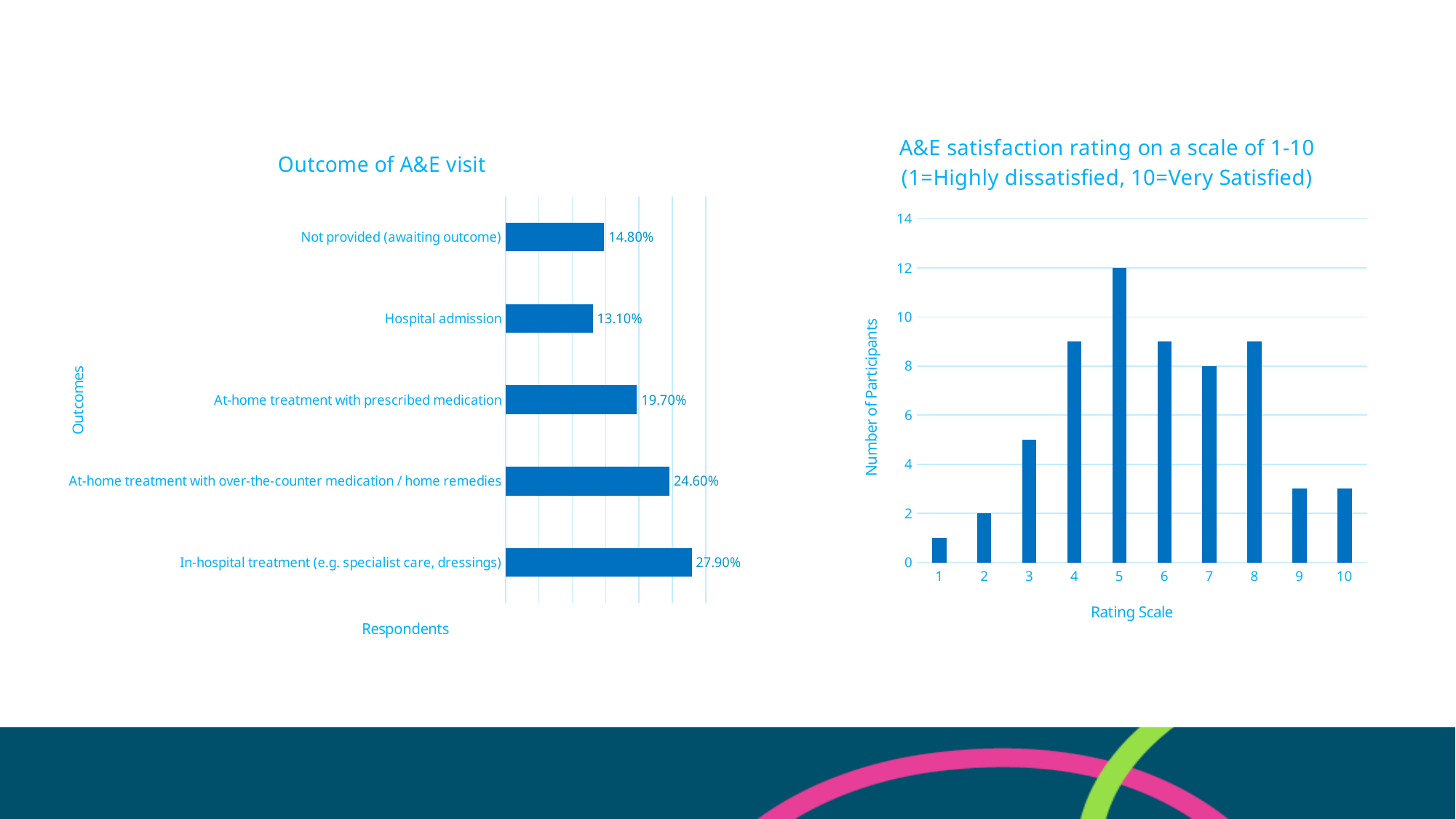
In the 'Outcome of A&E visit' chart, which outcome has the lowest percentage of respondents? Hospital admission What type of chart is the 'Outcome of A&E visit' chart? Bar chart In the 'Outcome of A&E visit' chart, what is the value for hospital admission? 13.10% In the 'A&E satisfaction rating' chart, how many participants gave a rating of 5? 12 In the 'Outcome of A&E visit' chart, what percentage of respondents had in-hospital treatment (e.g. specialist care, dressings)? 27.90% How many outcome categories are shown in the 'Outcome of A&E visit' chart? 5 In the 'A&E satisfaction rating' chart, which rating has more participants, 3 or 9? 3 In the 'A&E satisfaction rating' chart, is the number of participants for rating 4 greater or less than 8? greater In the 'Outcome of A&E visit' chart, which outcome has the highest percentage of respondents? In-hospital treatment (e.g. specialist care, dressings) In the 'Outcome of A&E visit' chart, what is the difference between at-home treatment with over-the-counter medication / home remedies and at-home treatment with prescribed medication? 4.90% In the 'A&E satisfaction rating' chart, how many participants gave a rating of 7? 8 In the 'A&E satisfaction rating' chart, which rating has the highest number of participants? 5